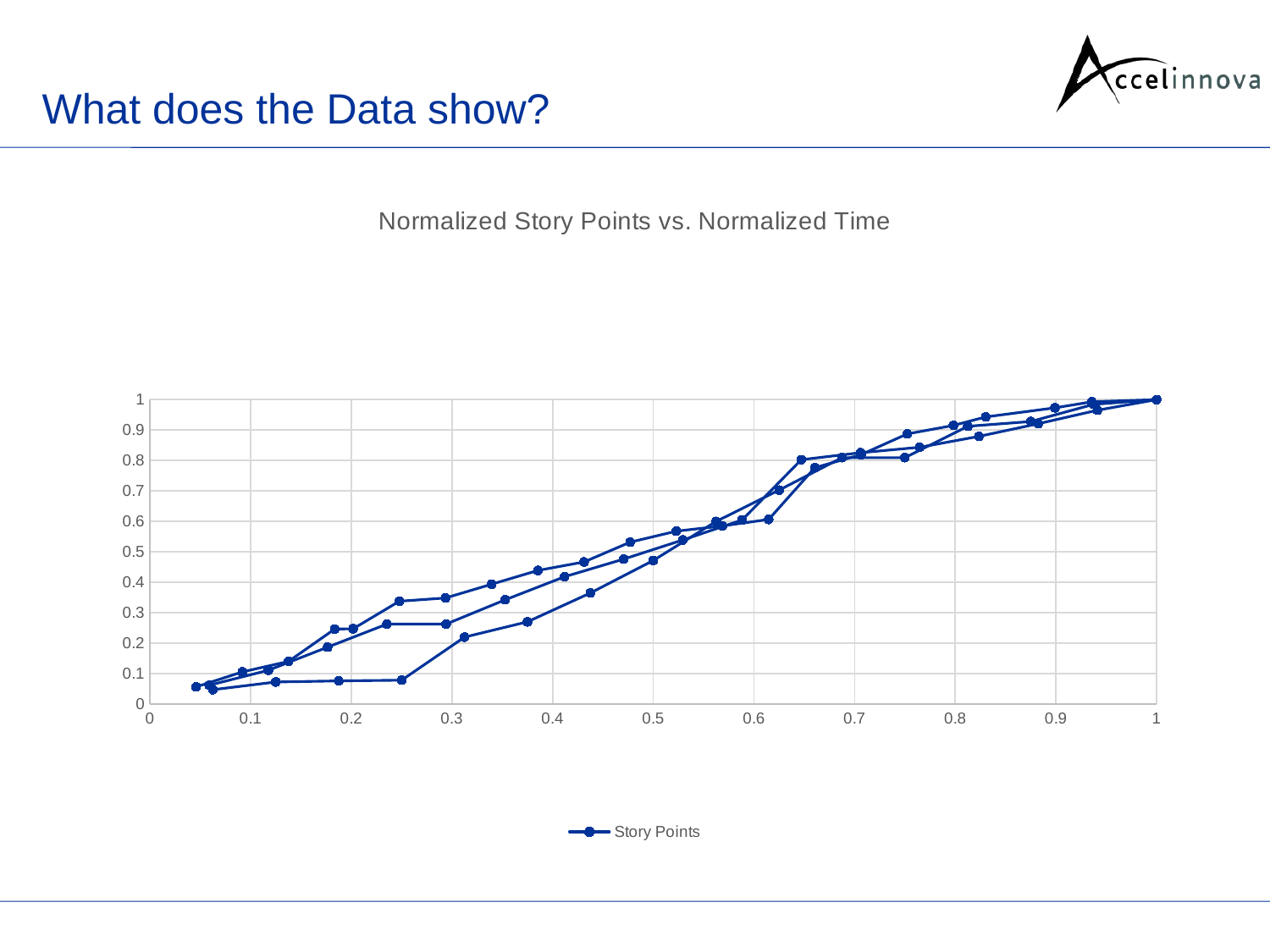
Are the plotted values at x = 0.2 greater or less than 0.4? less How many series does the legend list? 1 What is the highest tick value shown on the y axis? 1 Do the plotted values rise or fall as normalized time increases along the x axis? rise How many separate lines are plotted on the chart? 3 What is the title of the chart? Normalized Story Points vs. Normalized Time Are the plotted values at x = 0.9 greater or less than 0.8? greater What is the name of the series shown in the legend? Story Points Are the plotted values at x = 0.7 greater or less than 0.6? greater What value do all the lines reach at the right end of the x axis (x = 1)? 1 What kind of chart is shown on the slide? line chart